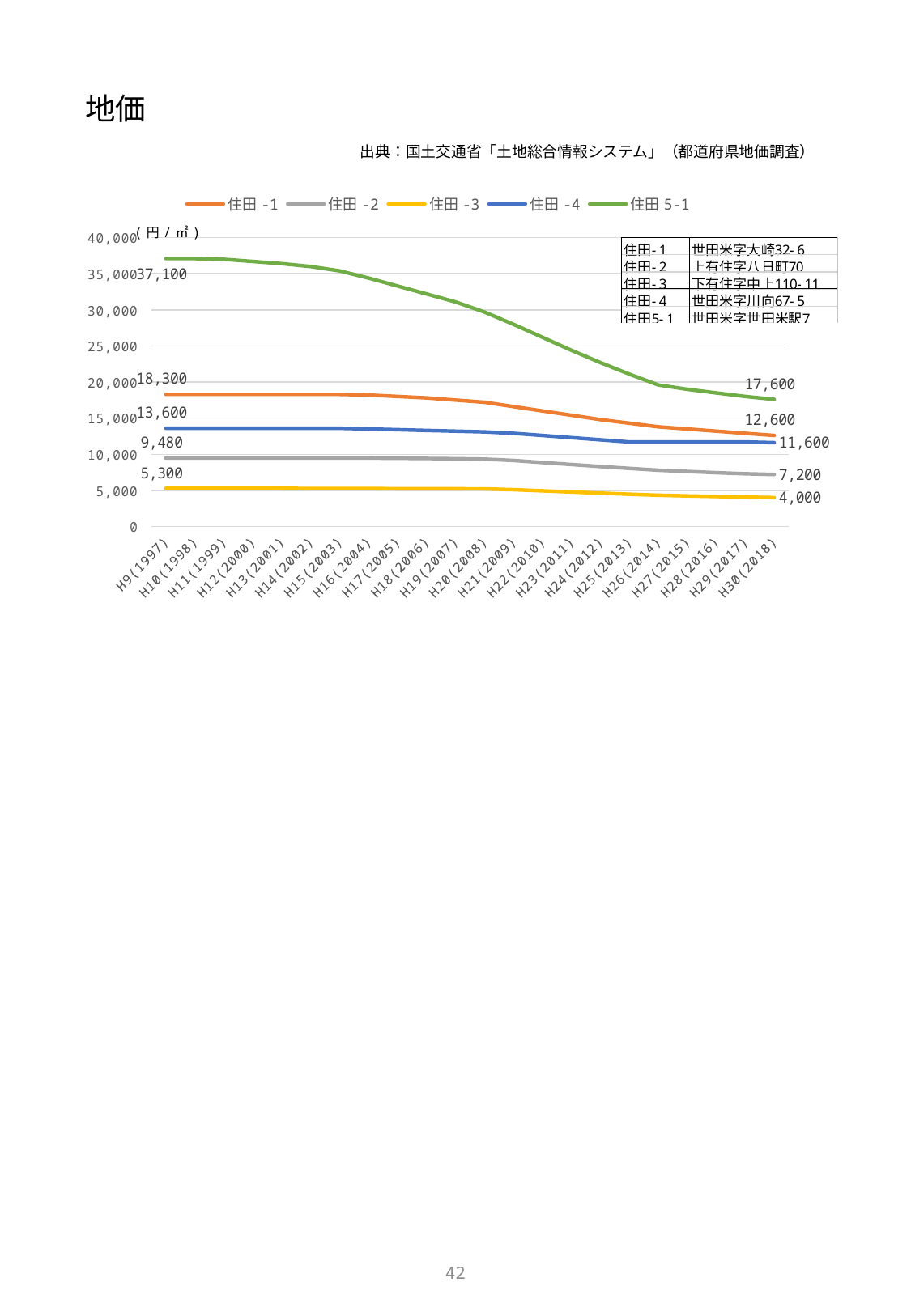
Is the value for 住田5-1 at H20(2008) greater or less than 25,000? greater Which is larger at H30(2018): the value for 住田-2 or the value for 住田-4? 住田-4 What is the value for 住田-1 at H30(2018)? 12,600 How many series does the legend list? 5 What is the difference between the 住田5-1 values at H9(1997) and H30(2018)? 19,500 Which series has the highest value at H30(2018)? 住田5-1 Do the values for 住田-1 rise or fall from H9(1997) to H30(2018)? fall What is the value for 住田-4 at H30(2018)? 11,600 What kind of chart is shown on the slide? line chart What is the value for 住田5-1 at H9(1997)? 37,100 What is the value for 住田-3 at H9(1997)? 5,300 Which series has the lowest value at H9(1997)? 住田-3